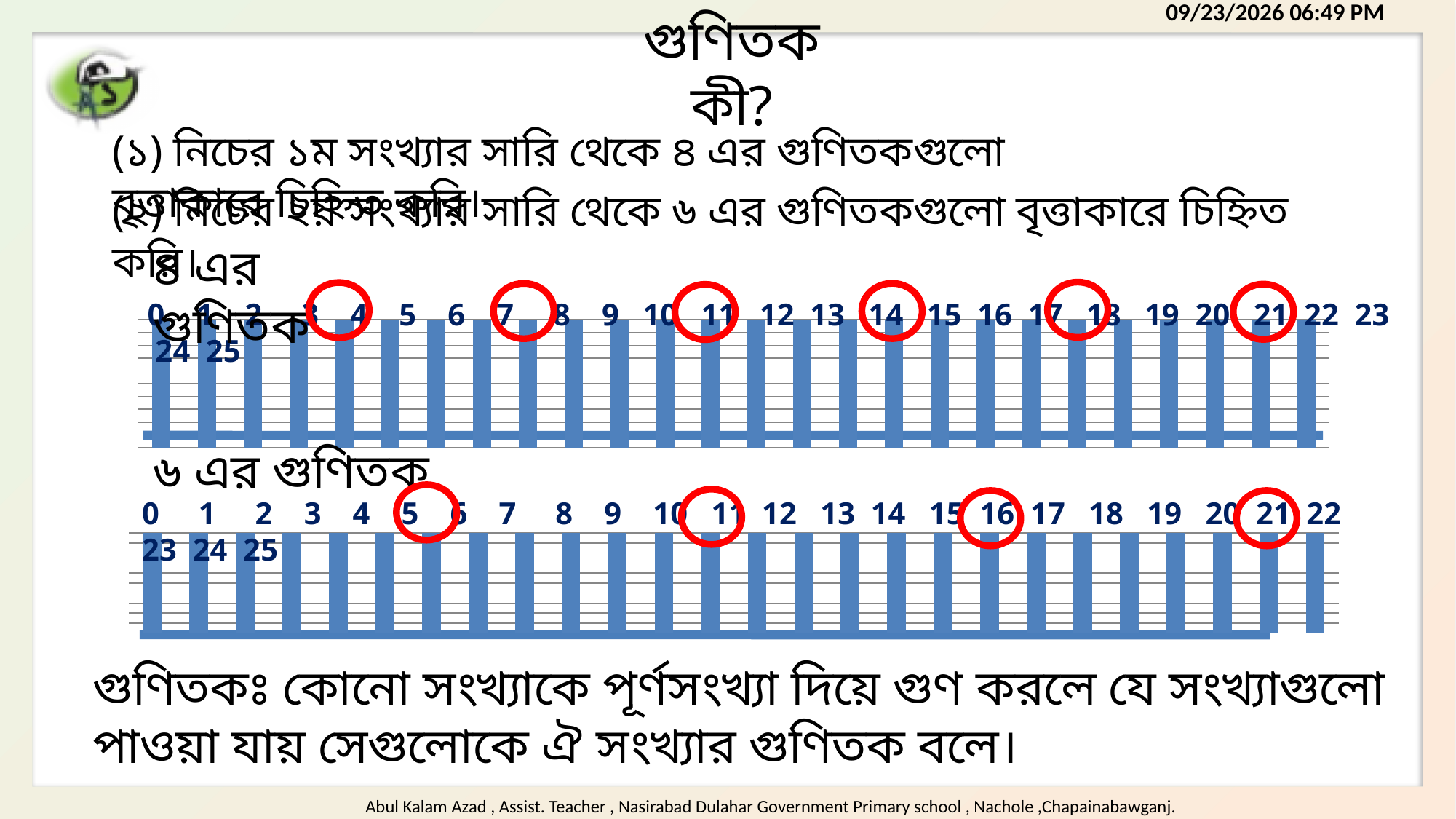
What kind of chart is the bottom chart (labelled ৬ এর গুণিতক)? bar chart In the top chart, how many numbers are marked with red circles? 6 How many numbered positions (0 through 25) are labelled along the bottom chart? 26 How many numbered positions (0 through 25) are labelled along the top chart? 26 What kind of chart is the top chart (labelled ৪ এর গুণিতক)? bar chart In the bottom chart, how many numbers are marked with red circles? 4 In the top chart, do the bar heights rise, fall, or stay the same from left to right? stay the same In the bottom chart, do the bar heights rise, fall, or stay the same from left to right? stay the same